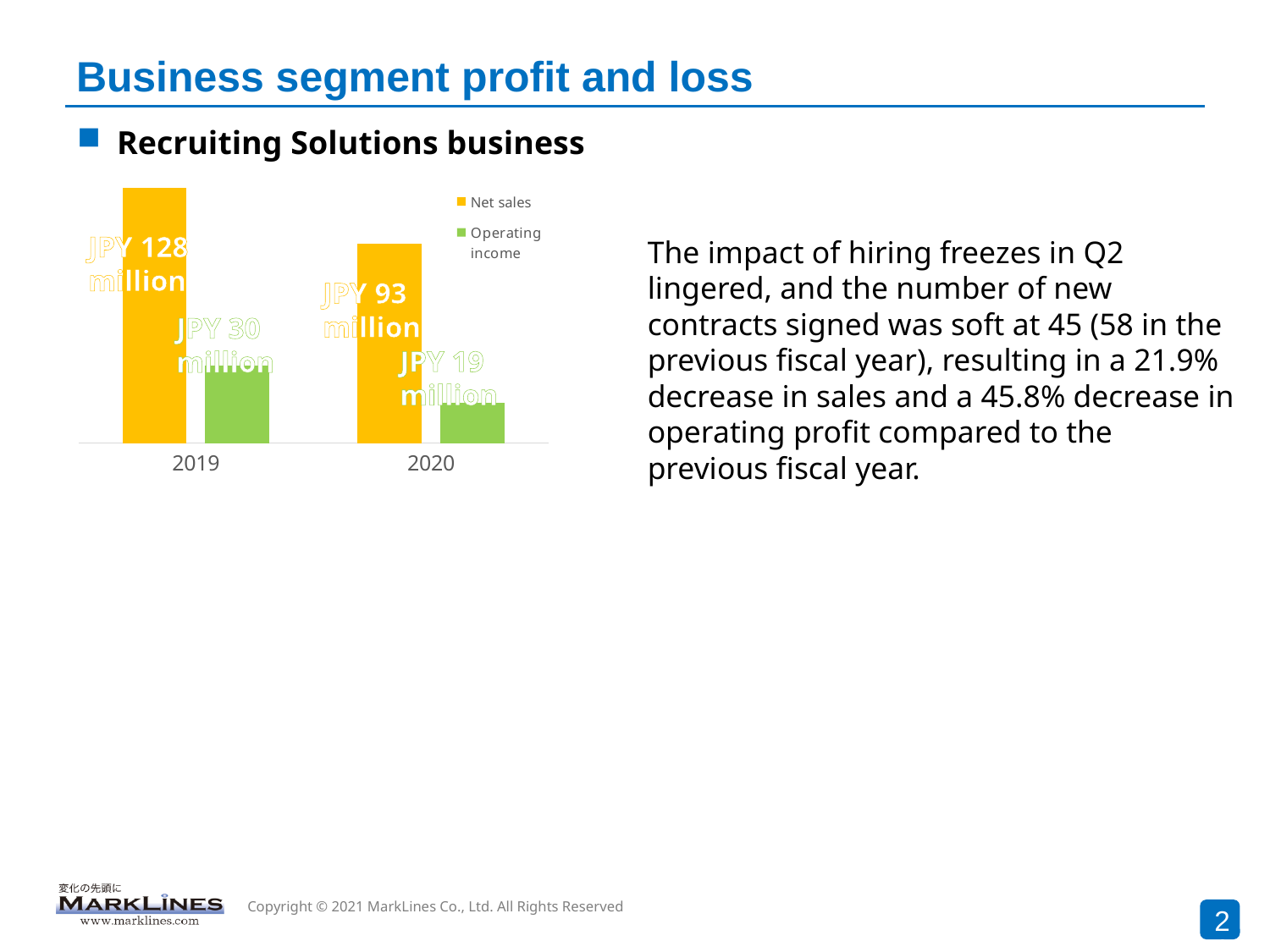
What was Operating income in 2019? JPY 30 million What was Operating income in 2020? JPY 19 million Do Net sales rise or fall from 2019 to 2020? Fall What was Net sales in 2019? JPY 128 million How many series does the legend list? 2 By how much did Net sales fall from 2019 to 2020? JPY 35 million What kind of chart is shown on the slide? Bar chart Which year had higher Net sales, 2019 or 2020? 2019 What is the difference between Operating income in 2019 and 2020? JPY 11 million How many years are shown on the x axis? 2 What was Net sales in 2020? JPY 93 million Which year had the lowest Operating income? 2020